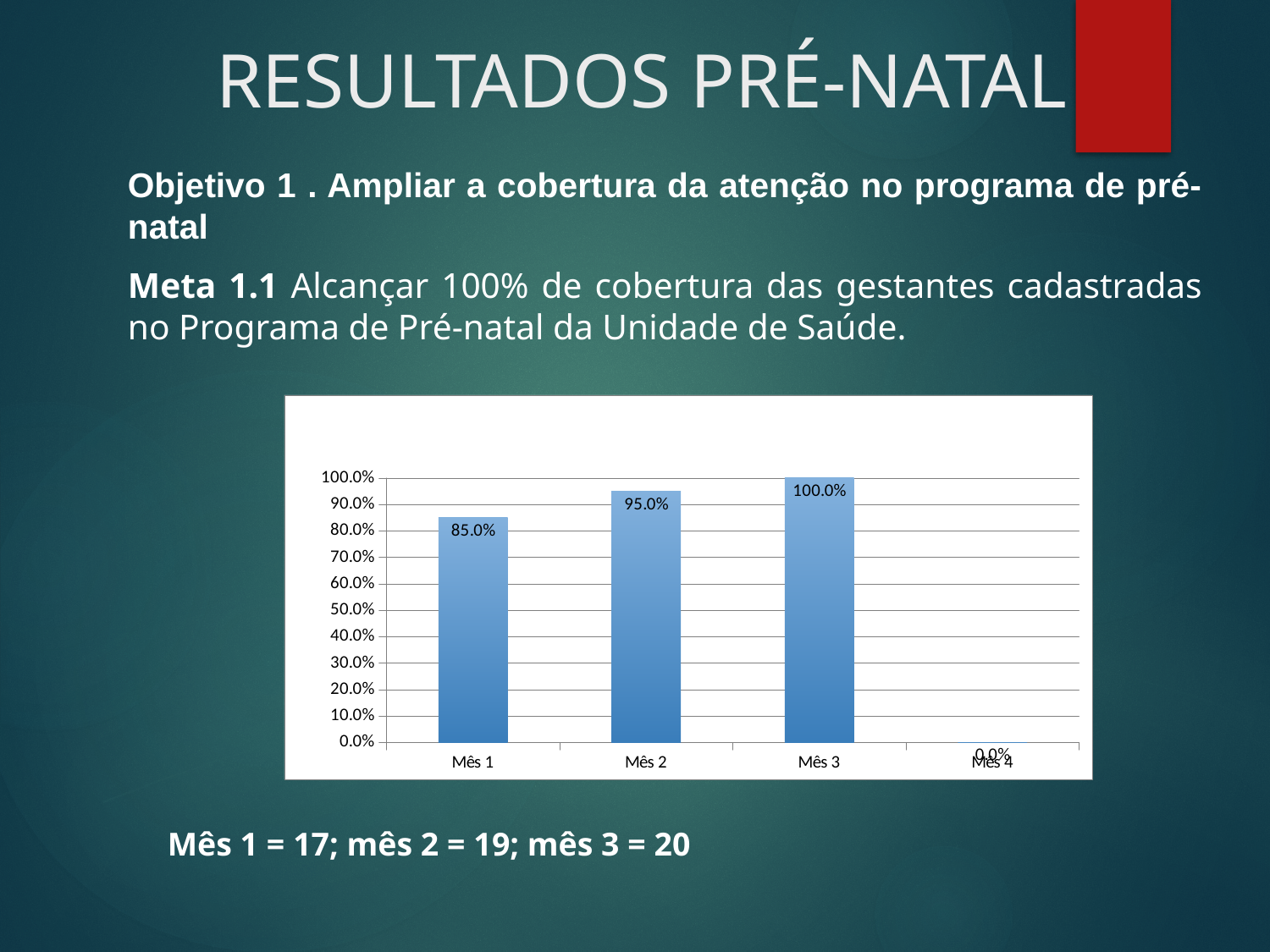
What is the difference between the values for Mês 3 and Mês 1? 15.0% Which category has the lowest value? Mês 4 What is the difference between the values for Mês 2 and Mês 1? 10.0% Do the values rise or fall from Mês 1 to Mês 3? Rise Which is larger, the value for Mês 2 or the value for Mês 1? Mês 2 What is the value for Mês 4? 0.0% What is the value for Mês 1? 85.0% What kind of chart is shown on the slide? Bar chart What is the value for Mês 3? 100.0% What is the value for Mês 2? 95.0% How many categories are shown on the x axis? 4 Which category has the highest value? Mês 3